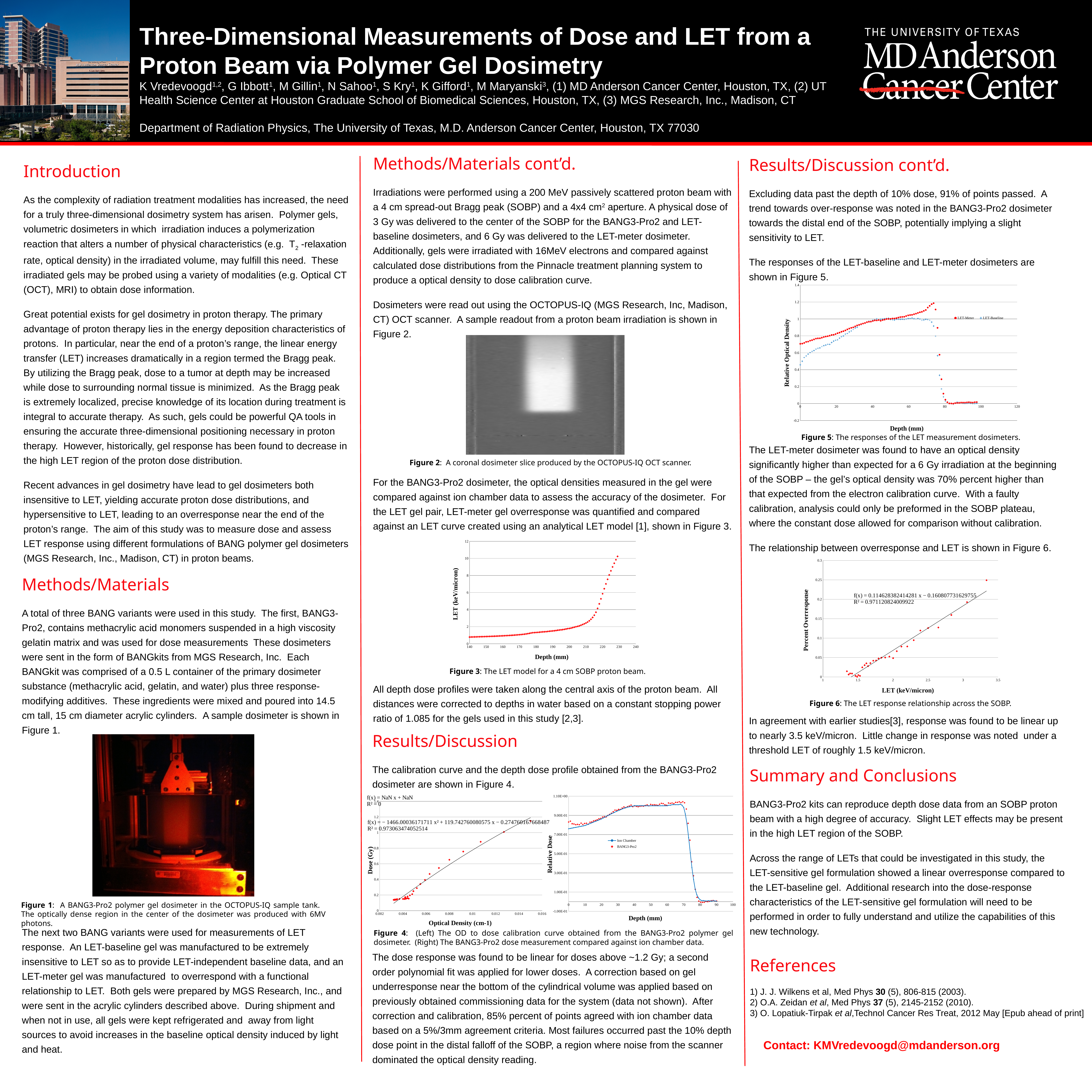
In Figure 3 (the LET model chart), is the LET value at a depth of 150 mm greater or less than 2 keV/micron? less In Figure 6 (the LET response relationship chart), does percent overresponse rise or fall as LET increases from 1.5 to 3.5 keV/micron? rise How many series does the legend list in the right-hand chart of Figure 4 (the depth dose comparison)? 2 In Figure 3 (the LET model chart), what is the label of the x axis? Depth (mm) In Figure 3 (the LET model chart), is the LET value at a depth of 230 mm greater or less than 8 keV/micron? greater What kind of chart is Figure 6 (the LET response relationship chart)? scatter chart What R² value is printed on Figure 6 (the LET response relationship chart)? 0.971120824009922 In Figure 3 (the LET model chart), do the LET values rise or fall as depth increases from 140 mm to 230 mm? rise What are the two series named in the legend of Figure 5? LET-Meter and LET-Baseline In Figure 5, is the relative optical density of the LET-Meter series at a depth of 100 mm greater or less than 0.4? less How many series does the legend list in Figure 5 (the LET measurement dosimeters chart)? 2